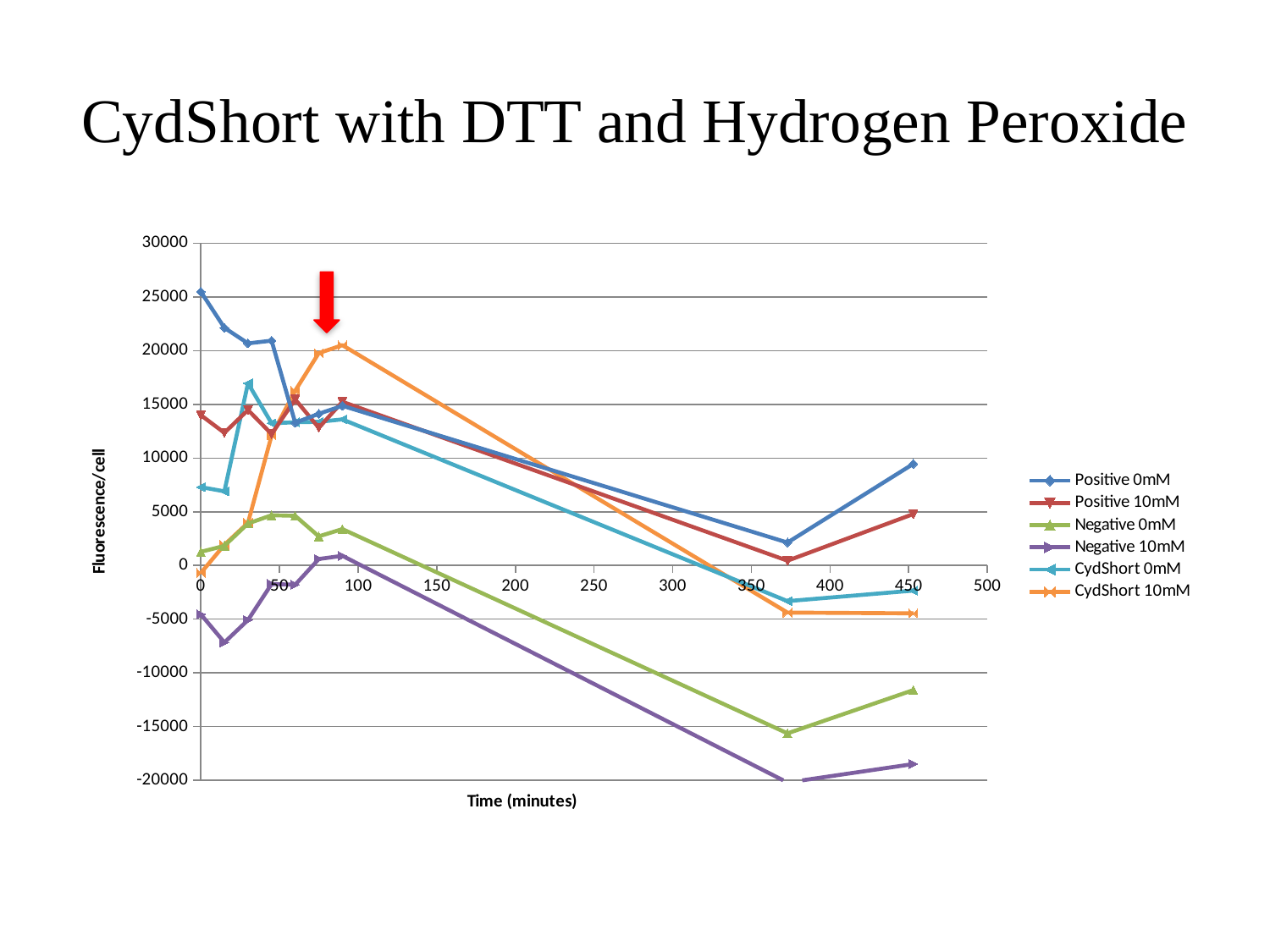
How many series does the legend list? 6 Is the value for Positive 0mM at about 450 minutes greater or less than 10000? less Which series has the lowest value at time 0? Negative 10mM Is the value for Negative 0mM at about 375 minutes greater or less than -15000? less What is the label of the x axis? Time (minutes) What is the label of the y axis? Fluorescence/cell Does the Negative 10mM series rise or fall between about 90 and 375 minutes? fall Which series has the highest value at time 0? Positive 0mM At time 0, which is larger: Positive 0mM or CydShort 0mM? Positive 0mM Is the peak value of CydShort 10mM (around 90 minutes) greater or less than 15000? greater What kind of chart is shown on the slide? line chart